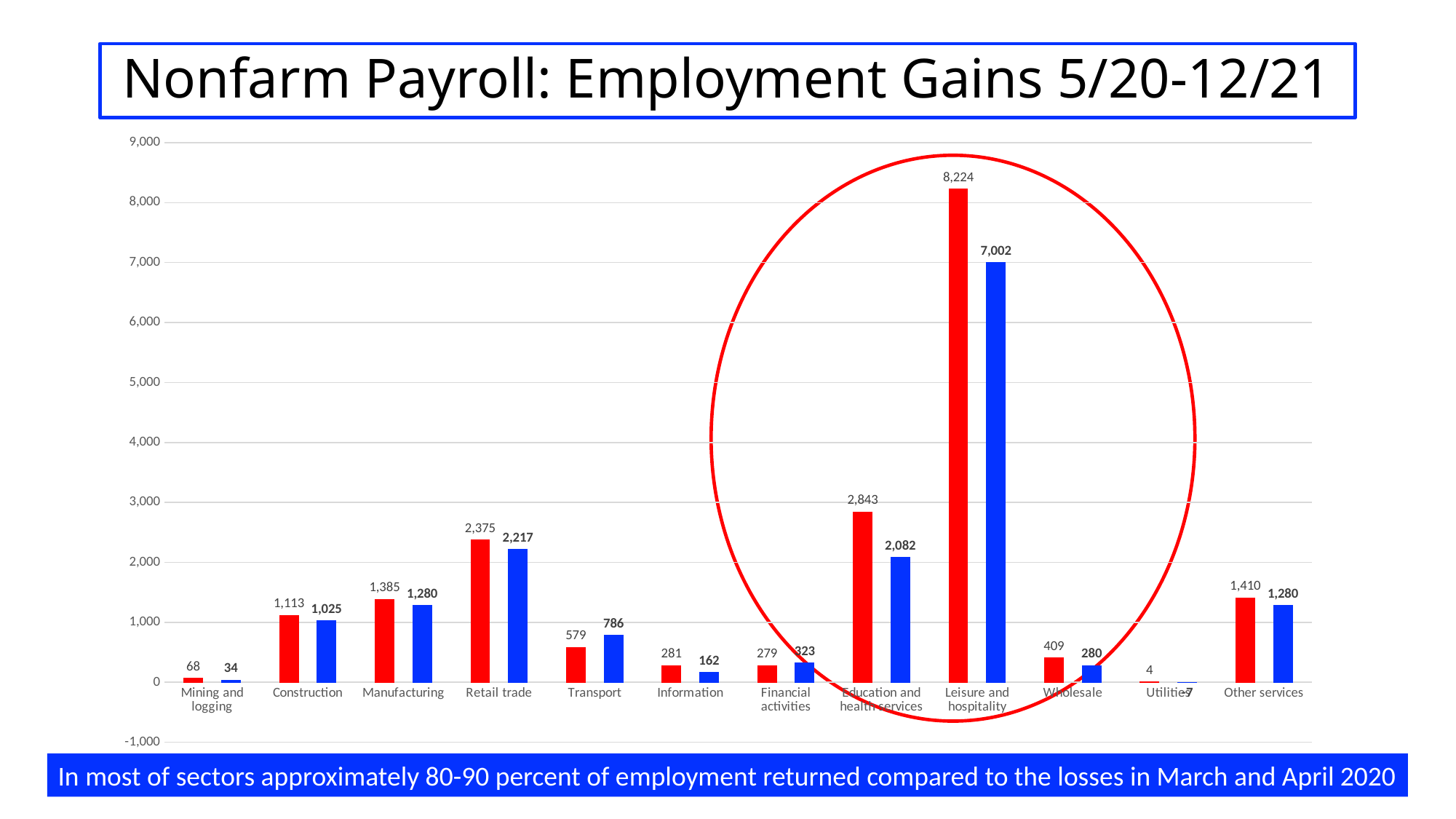
Is the red bar for Education and health services greater or less than 2,000? greater Which category has the highest red bar? Leisure and hospitality What is the value of the blue bar for Retail trade? 2,217 What kind of chart is shown on the slide? bar chart Which category has the lowest blue bar? Utilities What is the difference between the red and blue bars for Leisure and hospitality? 1,222 What is the value of the blue bar for Transport? 786 What is the value of the red bar for Leisure and hospitality? 8,224 What is the title of the chart? Nonfarm Payroll: Employment Gains 5/20-12/21 How many categories are shown on the x axis? 12 What is the value of the red bar for Education and health services? 2,843 Which is larger for Transport, the red bar or the blue bar? the blue bar